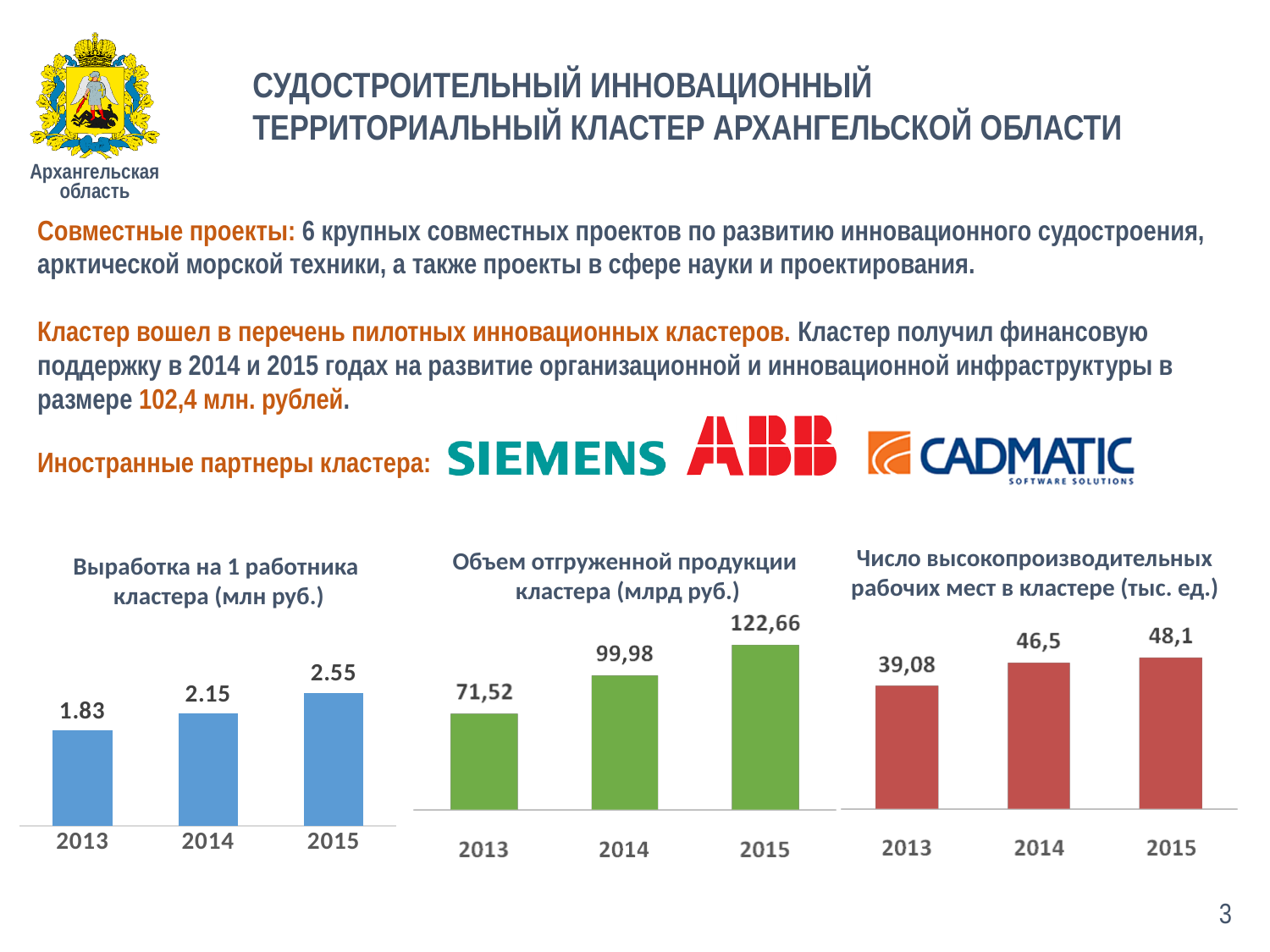
In the chart 'Объем отгруженной продукции кластера (млрд руб.)', what is the difference between the 2015 and 2013 values? 51,14 In the chart 'Объем отгруженной продукции кластера (млрд руб.)', which year has the highest value? 2015 How many years are shown in the chart 'Выработка на 1 работника кластера (млн руб.)'? 3 In the chart 'Выработка на 1 работника кластера (млн руб.)', do the values rise or fall from 2013 to 2015? Rise In the chart 'Число высокопроизводительных рабочих мест в кластере (тыс. ед.)', which is larger, the value for 2013 or the value for 2015? 2015 In the chart 'Число высокопроизводительных рабочих мест в кластере (тыс. ед.)', which year has the lowest value? 2013 In the chart 'Число высокопроизводительных рабочих мест в кластере (тыс. ед.)', what is the value for 2014? 46,5 In the chart 'Выработка на 1 работника кластера (млн руб.)', what is the value for 2015? 2.55 In the chart 'Объем отгруженной продукции кластера (млрд руб.)', what is the value for 2013? 71,52 In the chart 'Выработка на 1 работника кластера (млн руб.)', what is the difference between the 2015 and 2013 values? 0.72 What type of chart is 'Объем отгруженной продукции кластера (млрд руб.)'? Bar chart What colour are the bars in the rightmost chart, 'Число высокопроизводительных рабочих мест в кластере (тыс. ед.)'? Red